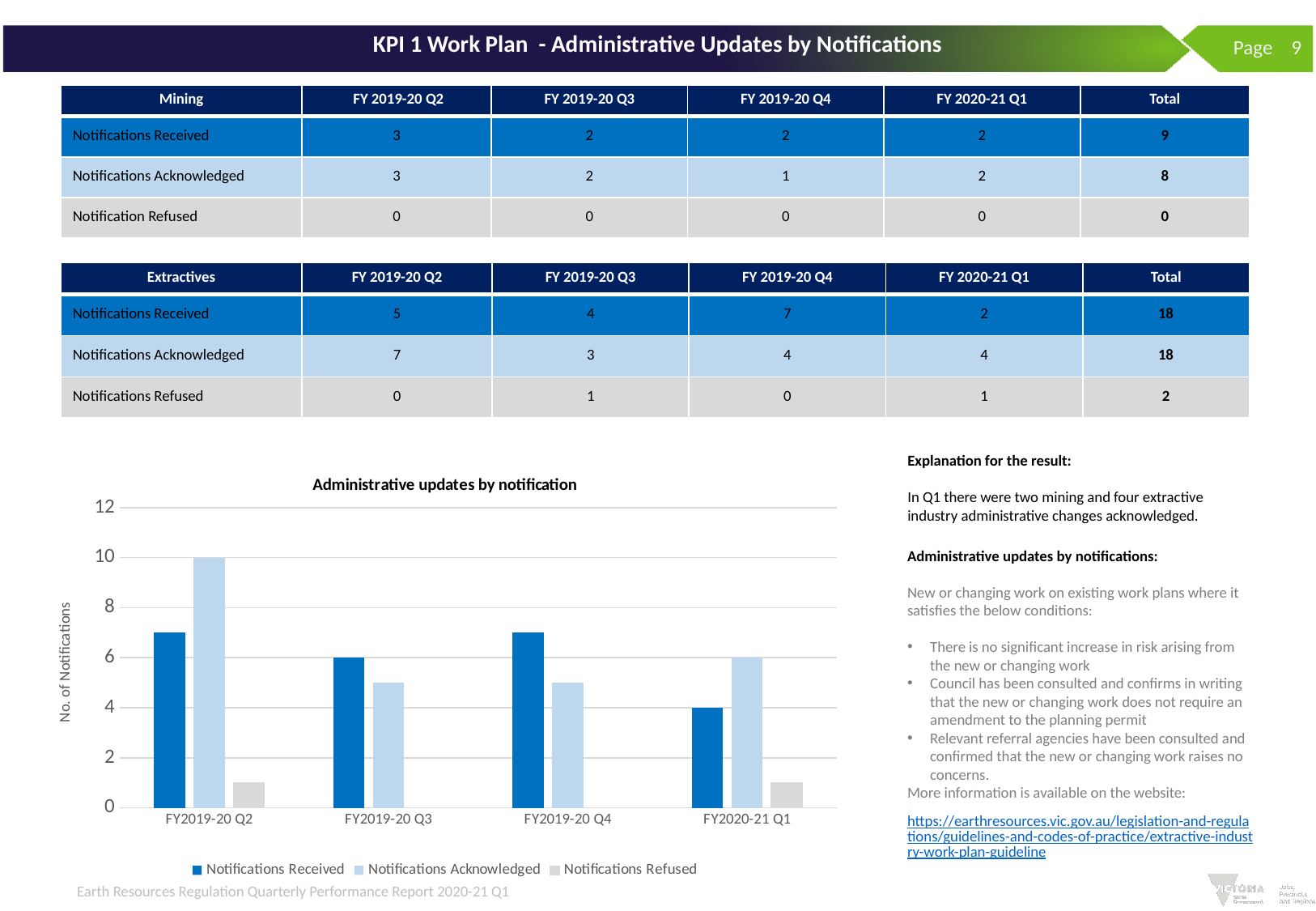
What is the value of Notifications Received for FY2019-20 Q3 in the chart? 6 In which quarter is Notifications Received lowest in the chart? FY2020-21 Q1 What is the value of Notifications Received for FY2020-21 Q1 in the chart? 4 What kind of chart is shown on the slide? bar chart How many series does the chart's legend list? 3 What is the title of the chart on the slide? Administrative updates by notification What is the value of Notifications Acknowledged for FY2019-20 Q2 in the chart? 10 How many quarters are shown along the x axis of the chart? 4 Is the value for Notifications Received in FY2019-20 Q4 greater or less than 6? greater Does Notifications Acknowledged rise or fall from FY2019-20 Q2 to FY2019-20 Q3 in the chart? fall For FY2020-21 Q1, which is larger in the chart: Notifications Received or Notifications Acknowledged? Notifications Acknowledged In which quarter is Notifications Acknowledged highest in the chart? FY2019-20 Q2